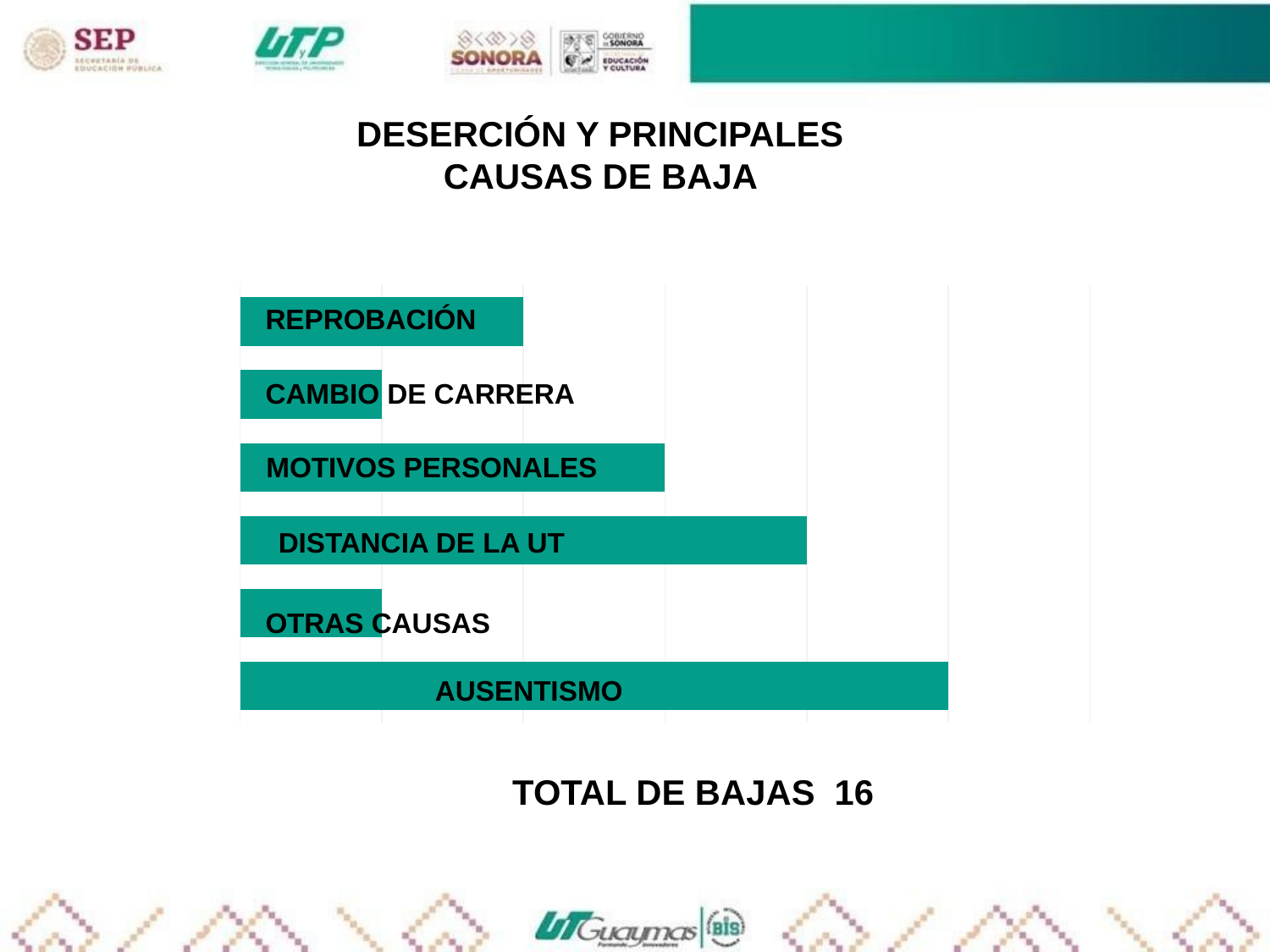
What kind of chart is shown on the slide? Bar chart How many causes (bars) are shown in the chart? 6 What total number of bajas is stated below the chart? 16 Which cause has the longest bar in the chart? AUSENTISMO Which is larger, the bar for MOTIVOS PERSONALES or the bar for REPROBACIÓN? MOTIVOS PERSONALES Which is larger, the bar for DISTANCIA DE LA UT or the bar for MOTIVOS PERSONALES? DISTANCIA DE LA UT Which is larger, the bar for DISTANCIA DE LA UT or the bar for AUSENTISMO? AUSENTISMO What is the title shown above the chart? DESERCIÓN Y PRINCIPALES CAUSAS DE BAJA Which cause has the second-longest bar in the chart? DISTANCIA DE LA UT